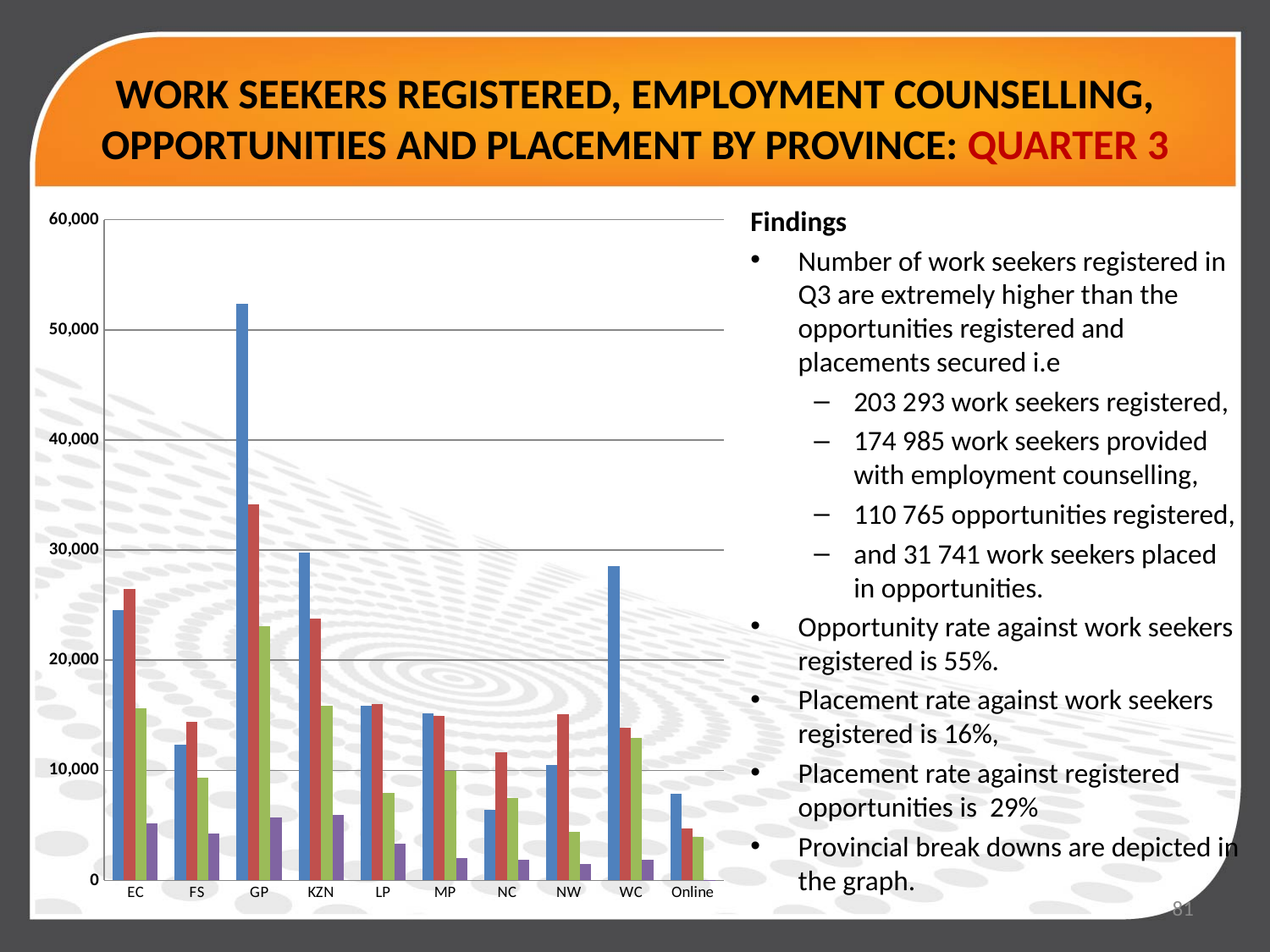
Which is larger, the red bar for EC or the red bar for FS? EC Is the blue bar for EC greater or less than 20,000? greater Is the blue bar for NC greater or less than 10,000? less Is the green bar for GP greater or less than 20,000? greater Which is larger, the blue bar for WC or the blue bar for EC? WC What is the highest value shown on the chart's vertical axis? 60,000 Which category has the tallest blue bar in the chart? GP How many categories are shown along the x axis of the chart? 10 What kind of chart is shown on the slide? Bar chart